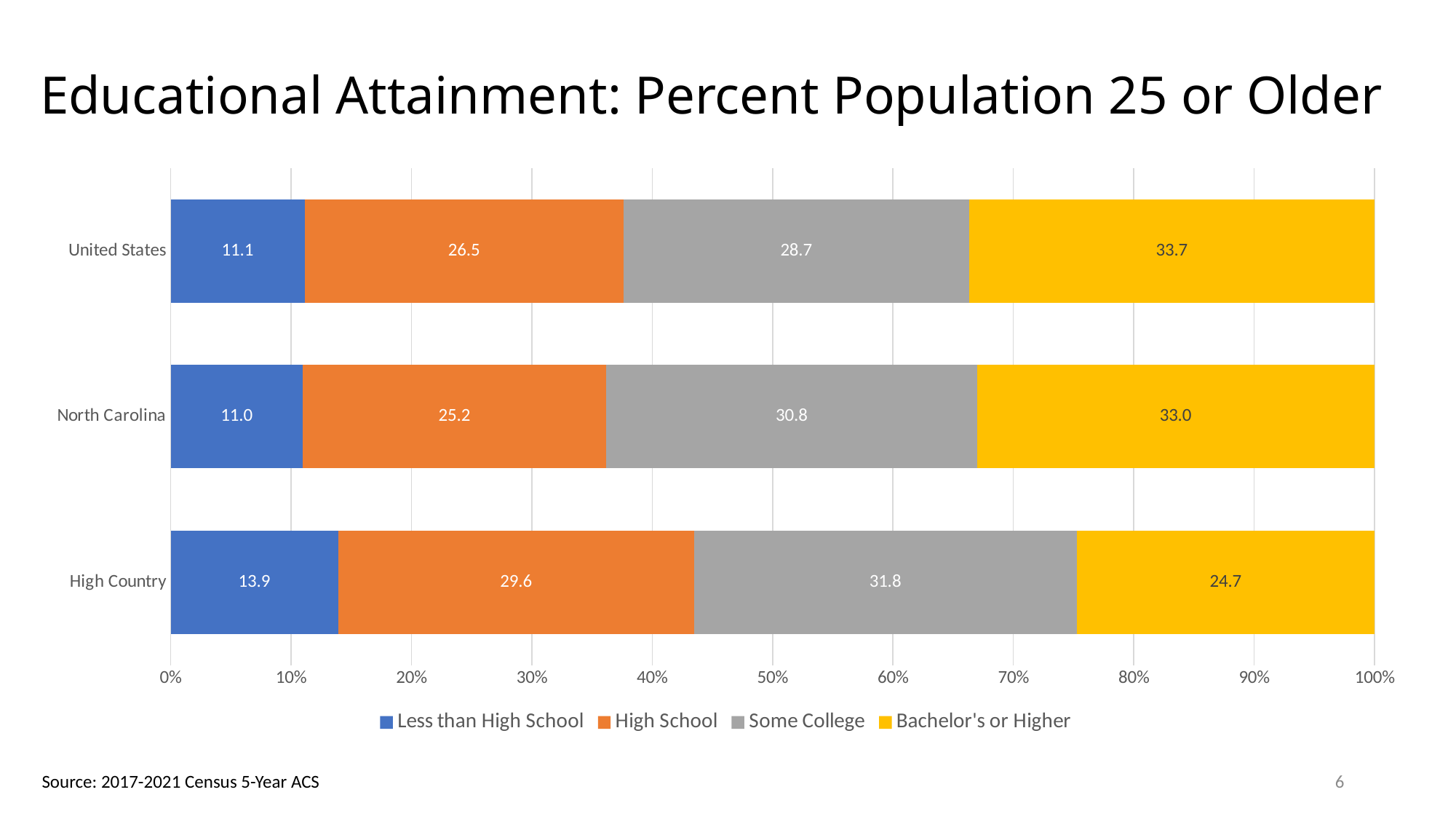
What kind of chart is shown on the slide? Stacked bar chart How many regions are shown on the chart? 3 What is the total of the stacked bar for North Carolina? 100.0 What is the Less than High School value for the United States? 11.1 What is the Bachelor's or Higher value for High Country? 24.7 How many series does the legend list? 4 Which region has the lowest Bachelor's or Higher value? High Country Which region has the highest Less than High School value? High Country Which is larger, the Some College value for High Country or for the United States? High Country What is the Some College value for North Carolina? 30.8 Which colour represents the High School series? Orange What is the difference between the High School values for High Country and North Carolina? 4.4